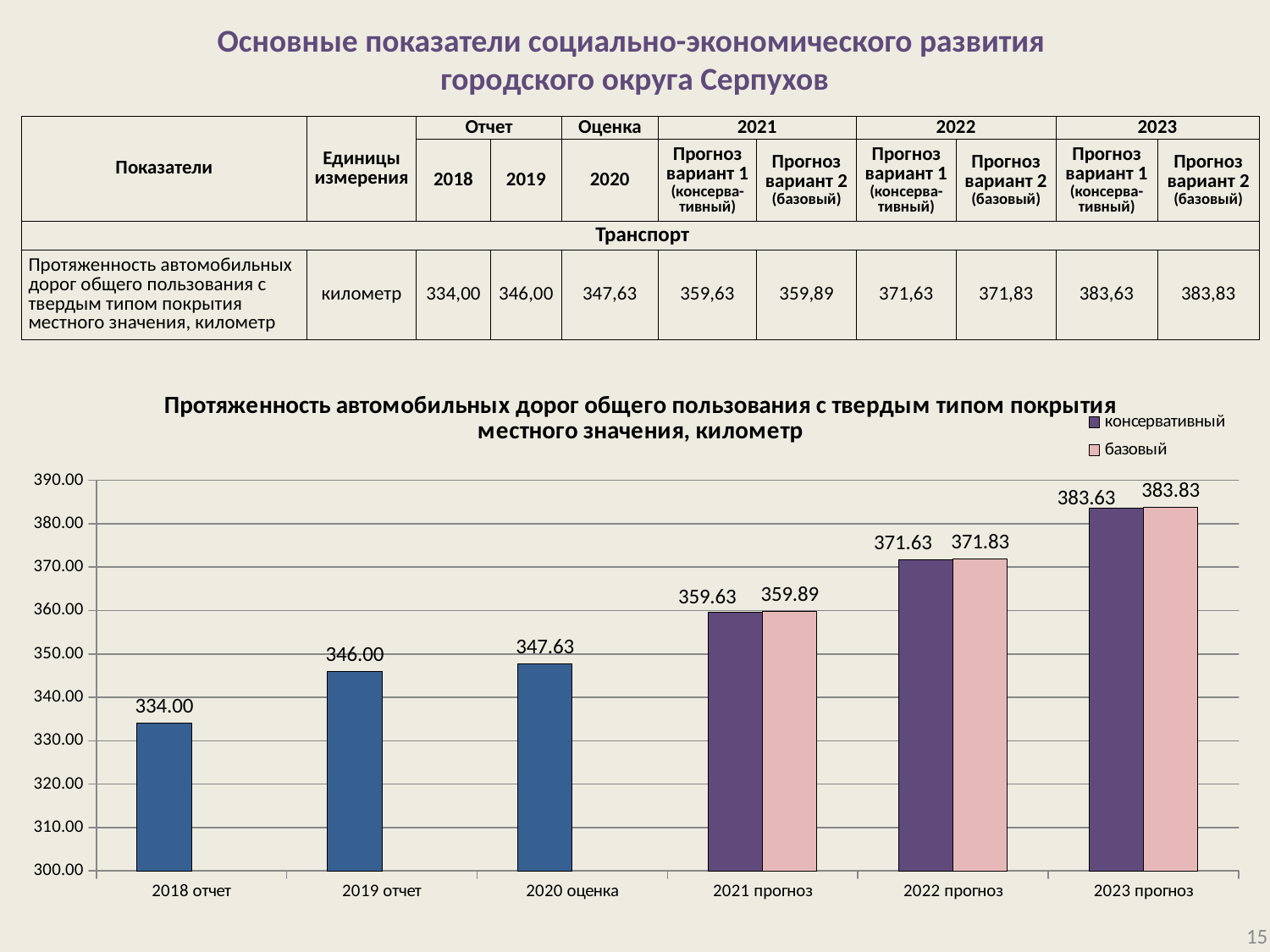
What is the консервативный value for 2023 прогноз in the chart? 383.63 How many categories are shown on the x axis of the chart? 6 How many series does the chart legend list? 2 What is the value for 2018 отчет in the chart? 334.00 What is the базовый value for 2021 прогноз in the chart? 359.89 What is the difference between the 2019 отчет value and the 2018 отчет value? 12.00 What is the value for 2020 оценка in the chart? 347.63 What is the difference between the базовый and консервативный values for 2022 прогноз? 0.20 Which category has the lowest value in the chart? 2018 отчет Which is larger: the консервативный value for 2022 прогноз or the базовый value for 2021 прогноз? консервативный value for 2022 прогноз What type of chart is shown on the slide? Bar chart Which category has the highest value in the chart? 2023 прогноз